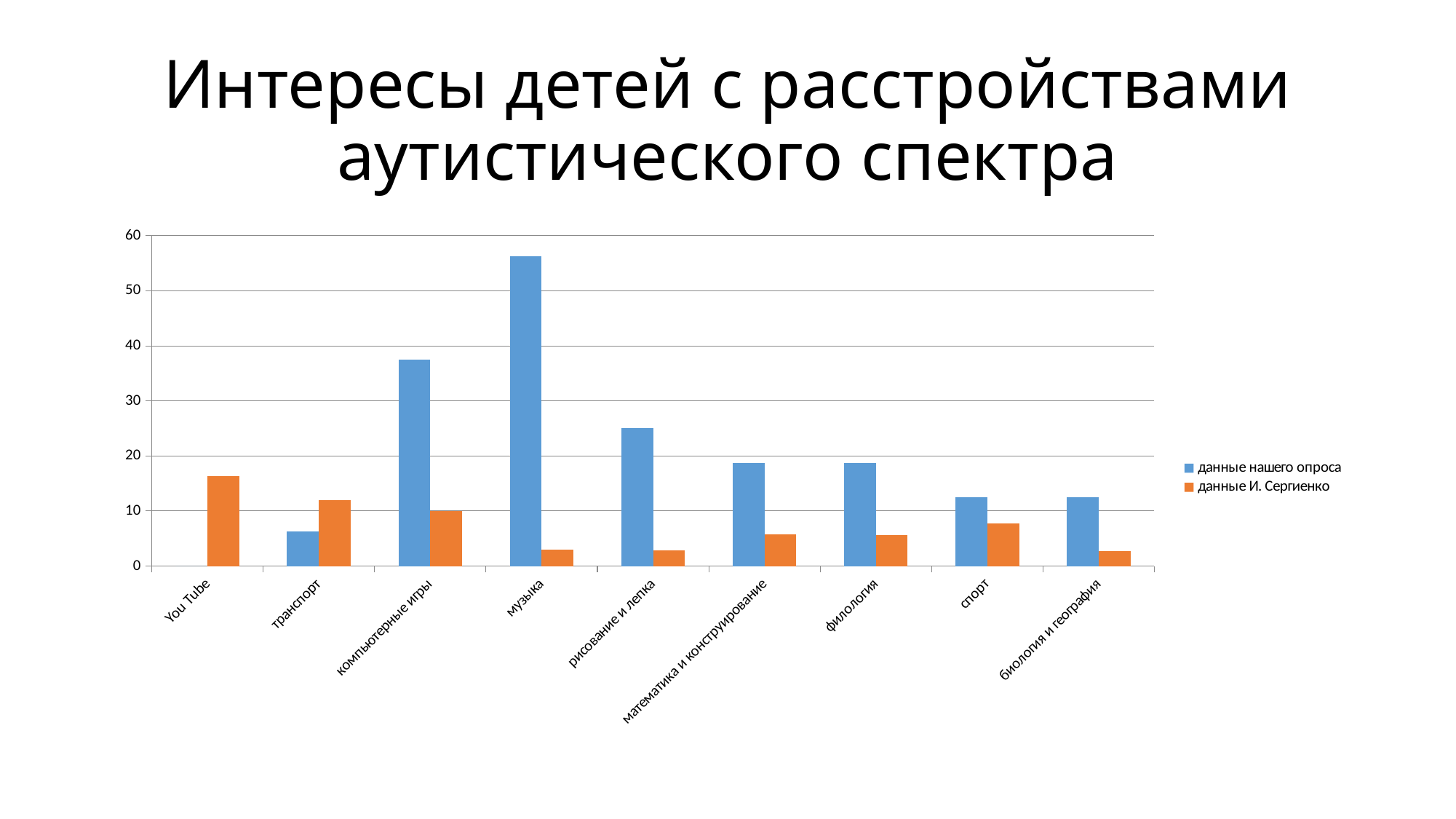
What colour are the bars for the series 'данные И. Сергиенко'? orange What kind of chart is shown on the slide? bar chart Is the value for 'рисование и лепка' in the series 'данные нашего опроса' greater or less than 20? greater Is the value for 'музыка' in the series 'данные нашего опроса' greater or less than 50? greater How many categories are shown on the x axis of the chart? 9 Which category has the highest value for the series 'данные И. Сергиенко'? You Tube Is the value for 'компьютерные игры' in the series 'данные нашего опроса' greater or less than 40? less For the category 'компьютерные игры', which series has the larger value: 'данные нашего опроса' or 'данные И. Сергиенко'? данные нашего опроса Which category has the highest value for the series 'данные нашего опроса'? музыка How many series does the legend list? 2 For the category 'транспорт', which series has the larger value: 'данные нашего опроса' or 'данные И. Сергиенко'? данные И. Сергиенко